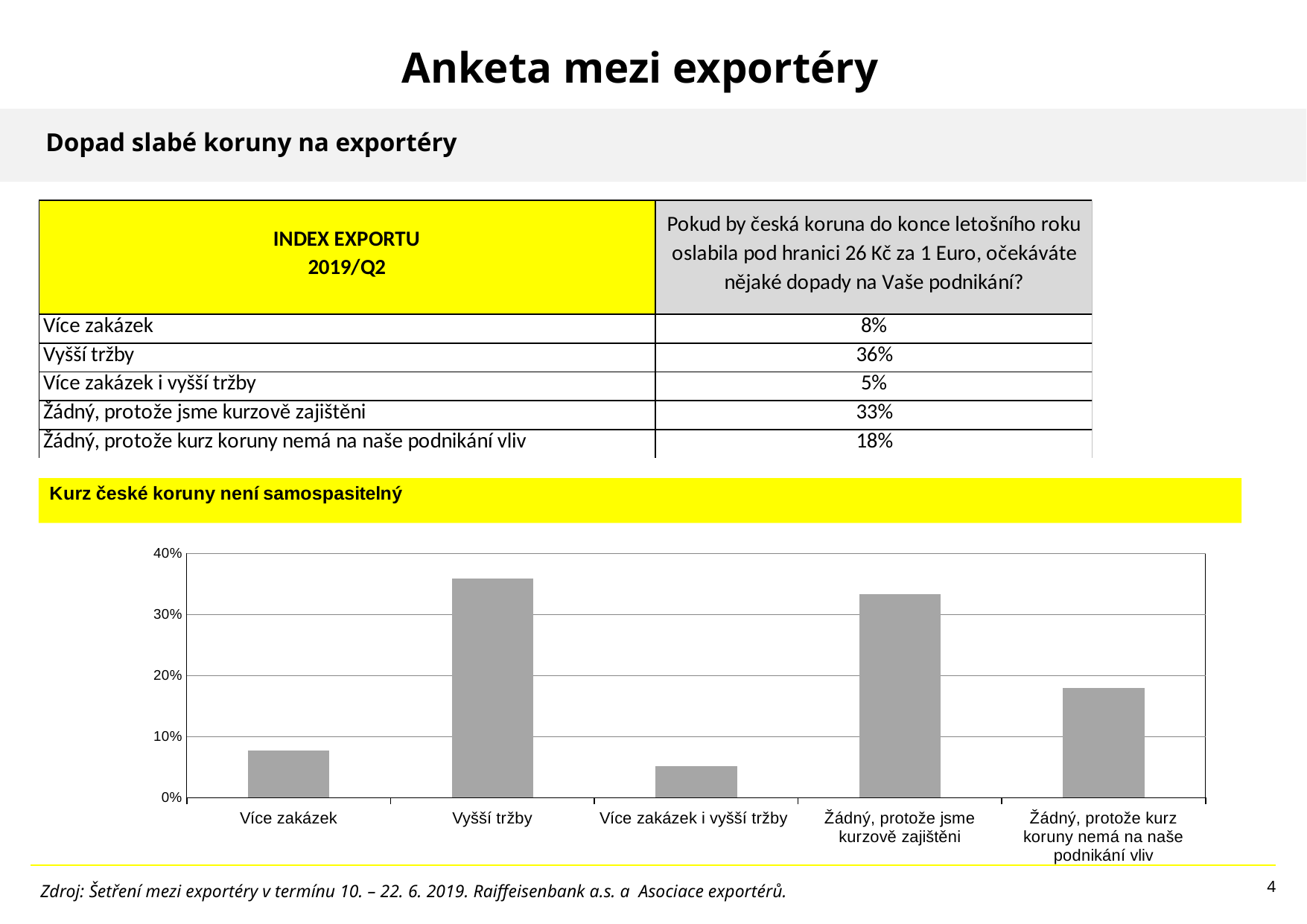
Which is larger: the value for Více zakázek or the value for Žádný, protože kurz koruny nemá na naše podnikání vliv? Žádný, protože kurz koruny nemá na naše podnikání vliv What is the difference between the values for Vyšší tržby and Žádný, protože jsme kurzově zajištěni? 3% Is the bar for Žádný, protože kurz koruny nemá na naše podnikání vliv greater or less than 20%? less What is the value for Vyšší tržby? 36% Is the bar for Vyšší tržby greater or less than 30%? greater How many categories are shown on the x axis of the bar chart? 5 Which category has the highest bar in the chart? Vyšší tržby What is the value for Žádný, protože jsme kurzově zajištěni? 33% What is the highest value shown on the y axis of the chart? 40% What is the value for Více zakázek? 8% What kind of chart is shown on the slide? bar chart Which category has the lowest bar in the chart? Více zakázek i vyšší tržby